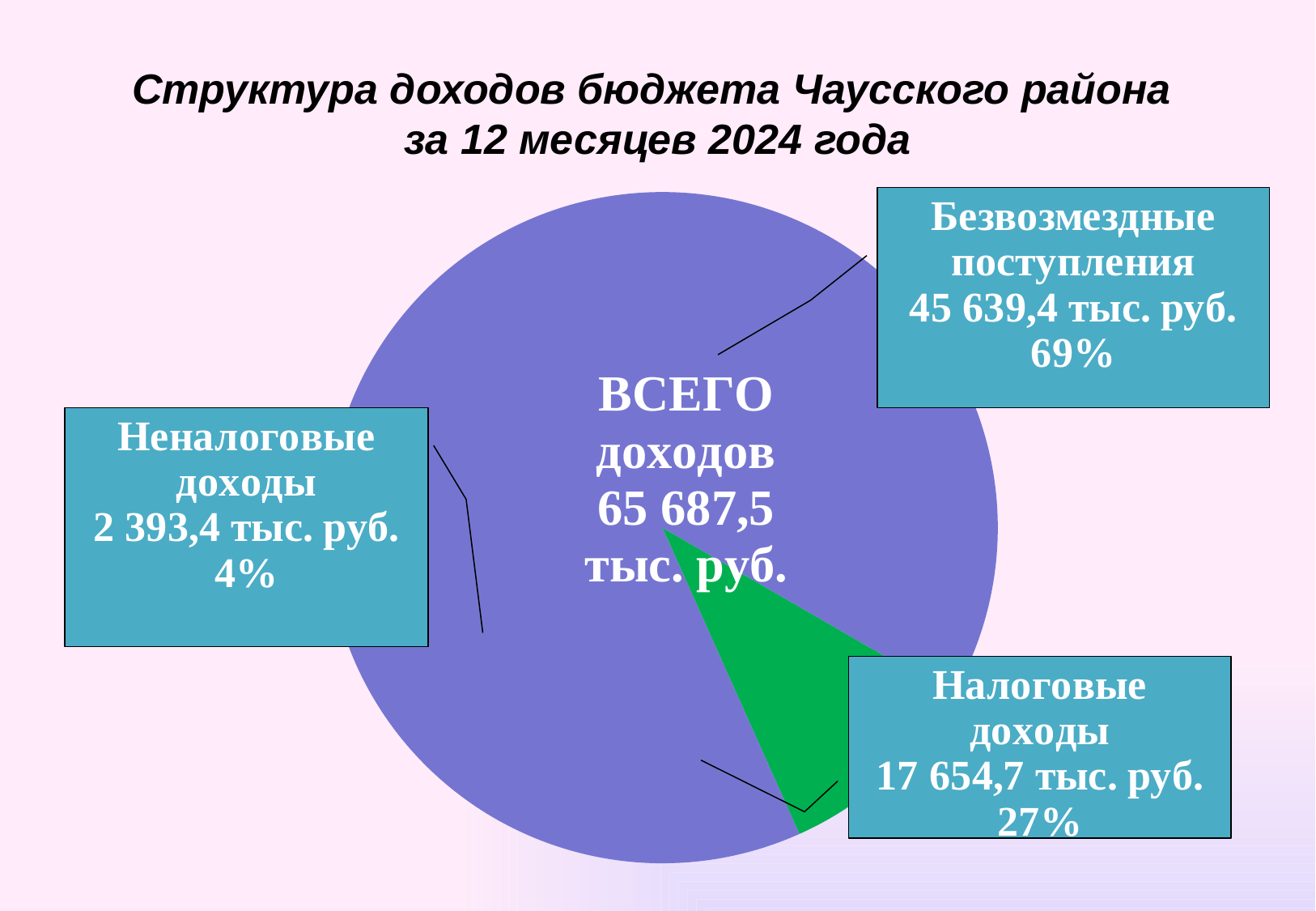
Which is larger, Налоговые доходы or Неналоговые доходы? Налоговые доходы How many categories does the pie chart show? 3 Which category has the largest value? Безвозмездные поступления What share of the pie do Безвозмездные поступления make up? 69% What share of the pie do Неналоговые доходы make up? 4% What is the value for Неналоговые доходы? 2 393,4 тыс. руб. What is the value for Налоговые доходы? 17 654,7 тыс. руб. What kind of chart is shown on the slide? pie chart Which category has the smallest value? Неналоговые доходы What is the value for Безвозмездные поступления? 45 639,4 тыс. руб. What is the total of all income shown in the centre of the pie chart? 65 687,5 тыс. руб. What share of the pie do Налоговые доходы make up? 27%